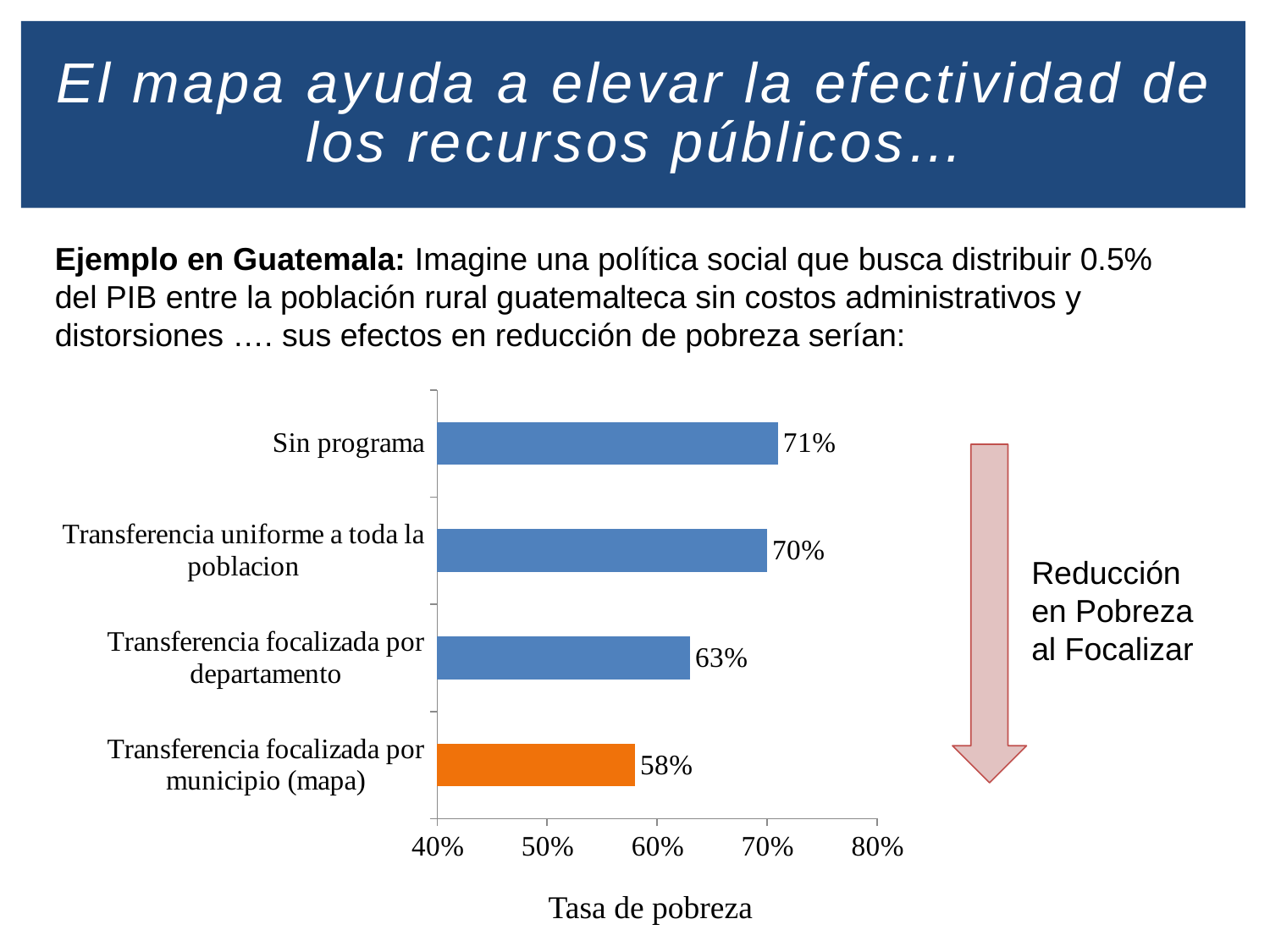
How many categories are shown in the chart? 4 What kind of chart is shown on the slide? Bar chart What is the value for 'Transferencia uniforme a toda la poblacion'? 70% What is the value for 'Transferencia focalizada por municipio (mapa)'? 58% What is the difference between 'Transferencia focalizada por departamento' and 'Transferencia focalizada por municipio (mapa)'? 5% What is the label on the horizontal axis of the chart? Tasa de pobreza Which is larger: the value for 'Transferencia uniforme a toda la poblacion' or for 'Transferencia focalizada por departamento'? Transferencia uniforme a toda la poblacion What is the value for 'Transferencia focalizada por departamento'? 63% What is the difference between the poverty rate for 'Sin programa' and for 'Transferencia focalizada por municipio (mapa)'? 13% What is the poverty rate (Tasa de pobreza) for 'Sin programa'? 71% Which category has the highest poverty rate? Sin programa Which category has the lowest poverty rate? Transferencia focalizada por municipio (mapa)